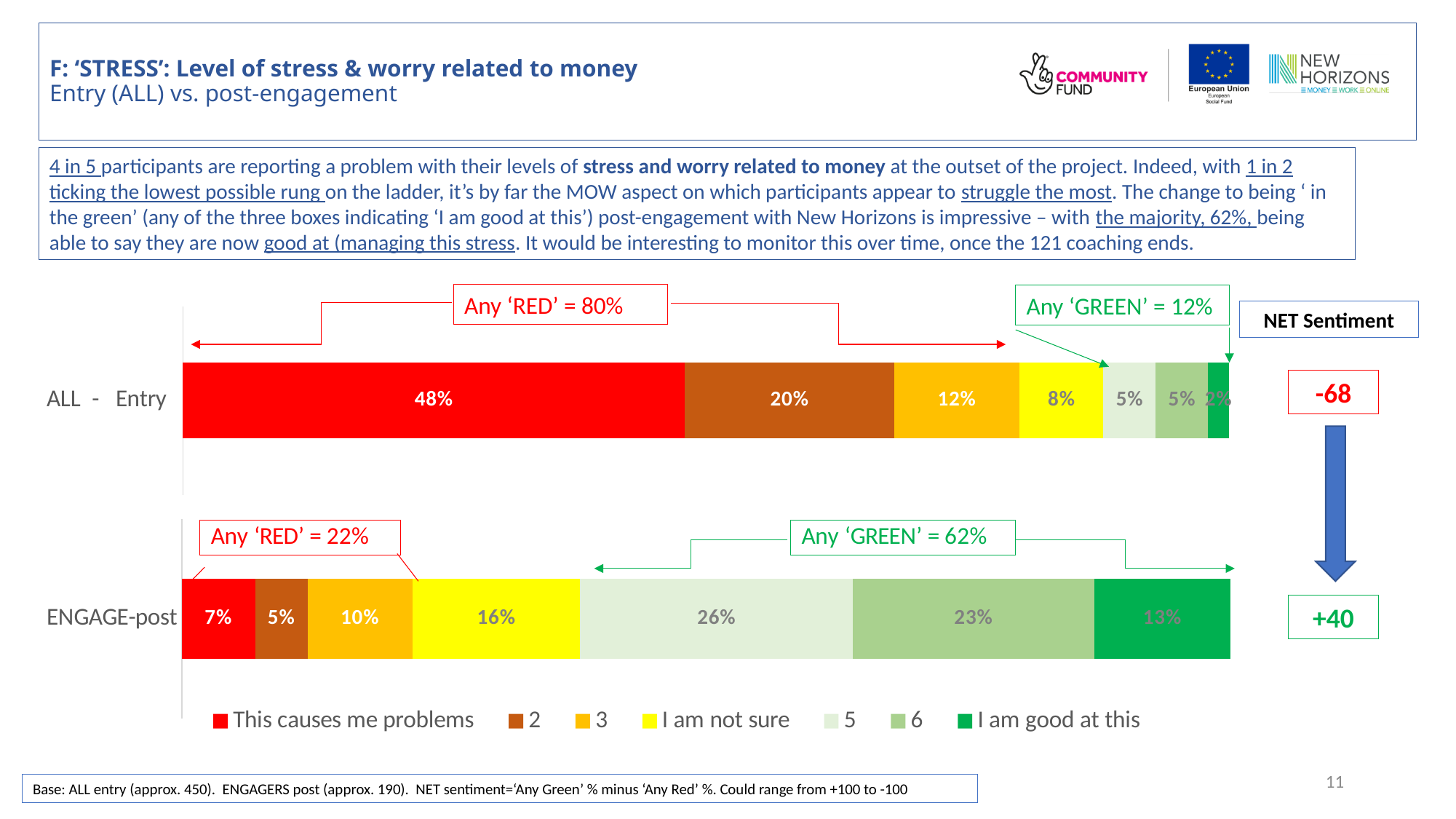
Which is larger: the category 6 share for ALL - Entry or for ENGAGE-post? ENGAGE-post What kind of chart is shown on the slide? Stacked bar chart Which segment is the smallest in the ALL - Entry bar? I am good at this How many bars are shown in the chart? 2 Which segment is the largest in the ENGAGE-post bar? 5 What percentage of the ENGAGE-post bar is 'I am not sure'? 16% What percentage of the ALL - Entry bar is 'This causes me problems'? 48% What is the NET Sentiment value shown for ENGAGE-post? +40 What percentage of the ENGAGE-post bar is 'I am good at this'? 13% How many series does the legend list? 7 What percentage of the ALL - Entry bar is category 2? 20% What is the difference between the 'This causes me problems' share for ALL - Entry and for ENGAGE-post? 41%